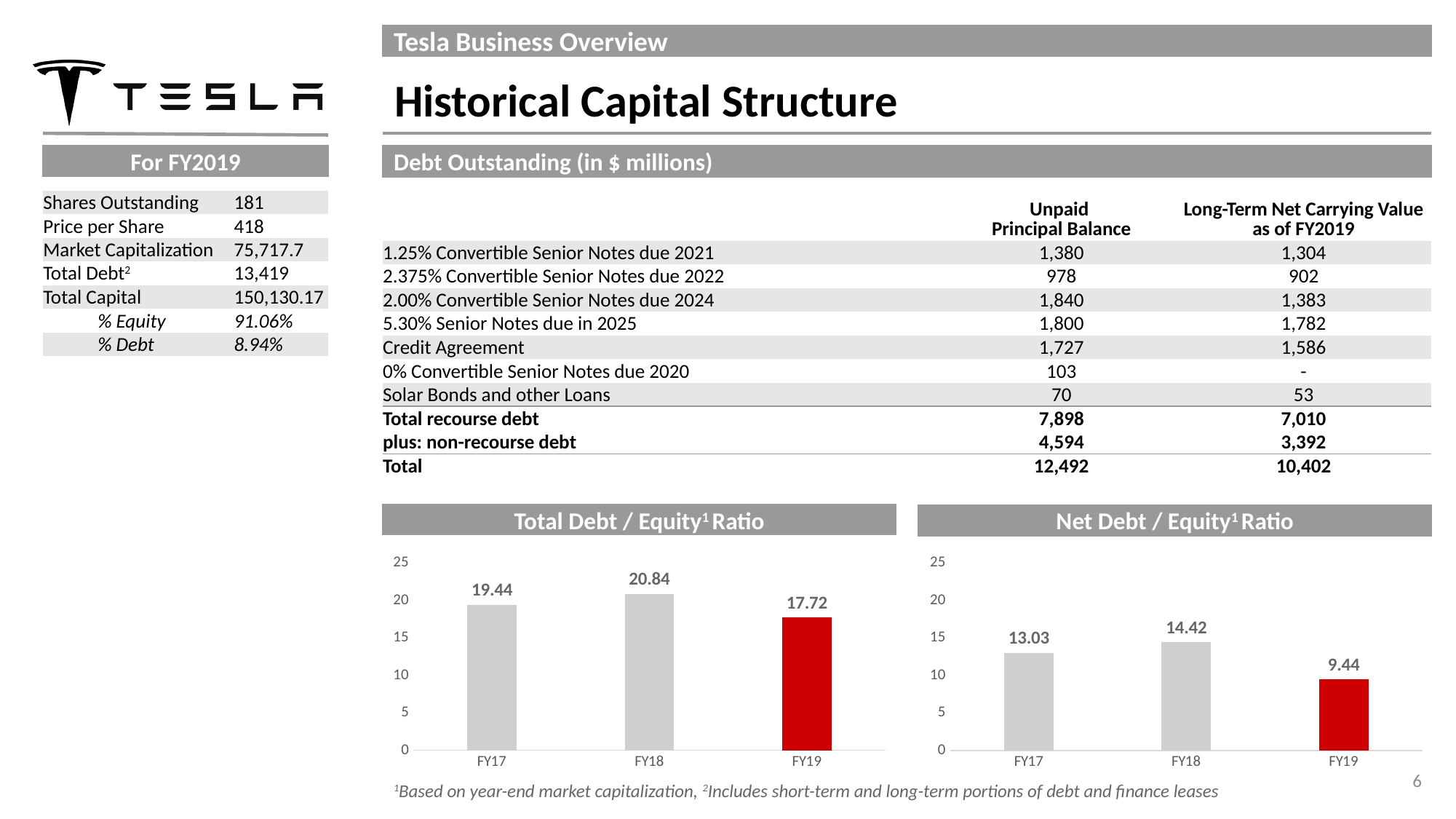
In the Total Debt / Equity Ratio chart, which year has the lowest value? FY19 In the Total Debt / Equity Ratio chart, is the value for FY19 greater or less than 20? less How many years are shown on the x axis of the Net Debt / Equity Ratio chart? 3 In the Net Debt / Equity Ratio chart, what is the difference between the FY17 and FY19 values? 3.59 In the Net Debt / Equity Ratio chart, what is the value for FY19? 9.44 In the Total Debt / Equity Ratio chart, what is the value for FY18? 20.84 In the Net Debt / Equity Ratio chart, which is larger, the value for FY17 or FY18? FY18 In the Net Debt / Equity Ratio chart, which year has the highest value? FY18 In the Total Debt / Equity Ratio chart, what is the difference between the FY18 and FY19 values? 3.12 In the Total Debt / Equity Ratio chart, what colour is the FY19 bar? red In the Net Debt / Equity Ratio chart, does the value rise or fall from FY18 to FY19? fall What kind of chart is the Total Debt / Equity Ratio chart? bar chart